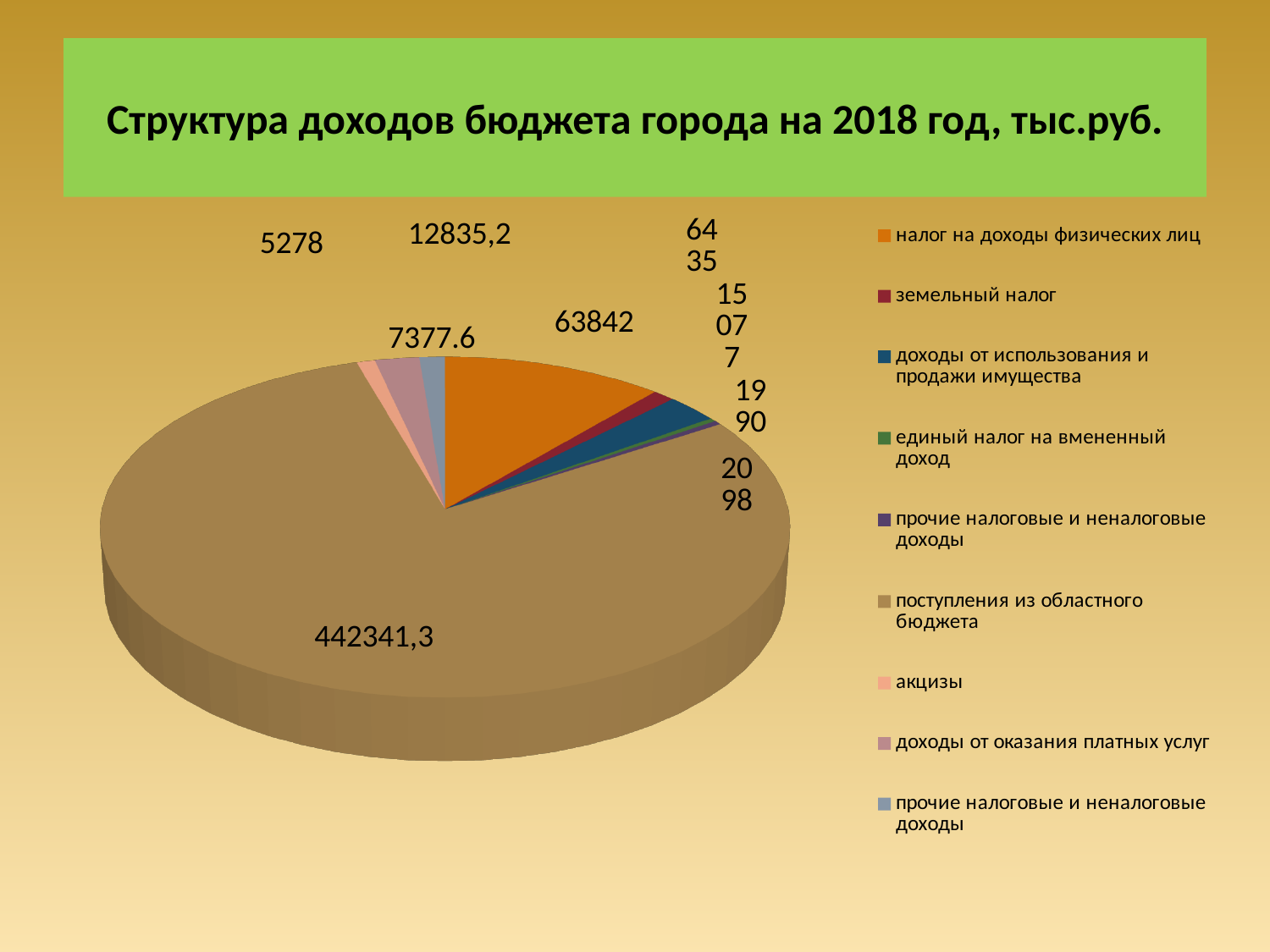
Which legend entry is shown in orange? налог на доходы физических лиц What is the value for поступления из областного бюджета? 442341,3 Which category has the largest slice of the pie? поступления из областного бюджета What is the value for налог на доходы физических лиц? 63842 What is the value for доходы от использования и продажи имущества? 15077 What kind of chart is shown on the slide? pie chart What is the difference between поступления из областного бюджета and налог на доходы физических лиц? 378499,3 How many categories does the legend list? 9 Which is larger, налог на доходы физических лиц or земельный налог? налог на доходы физических лиц What is the value for земельный налог? 6435 What is the title of the chart? Структура доходов бюджета города на 2018 год, тыс.руб.